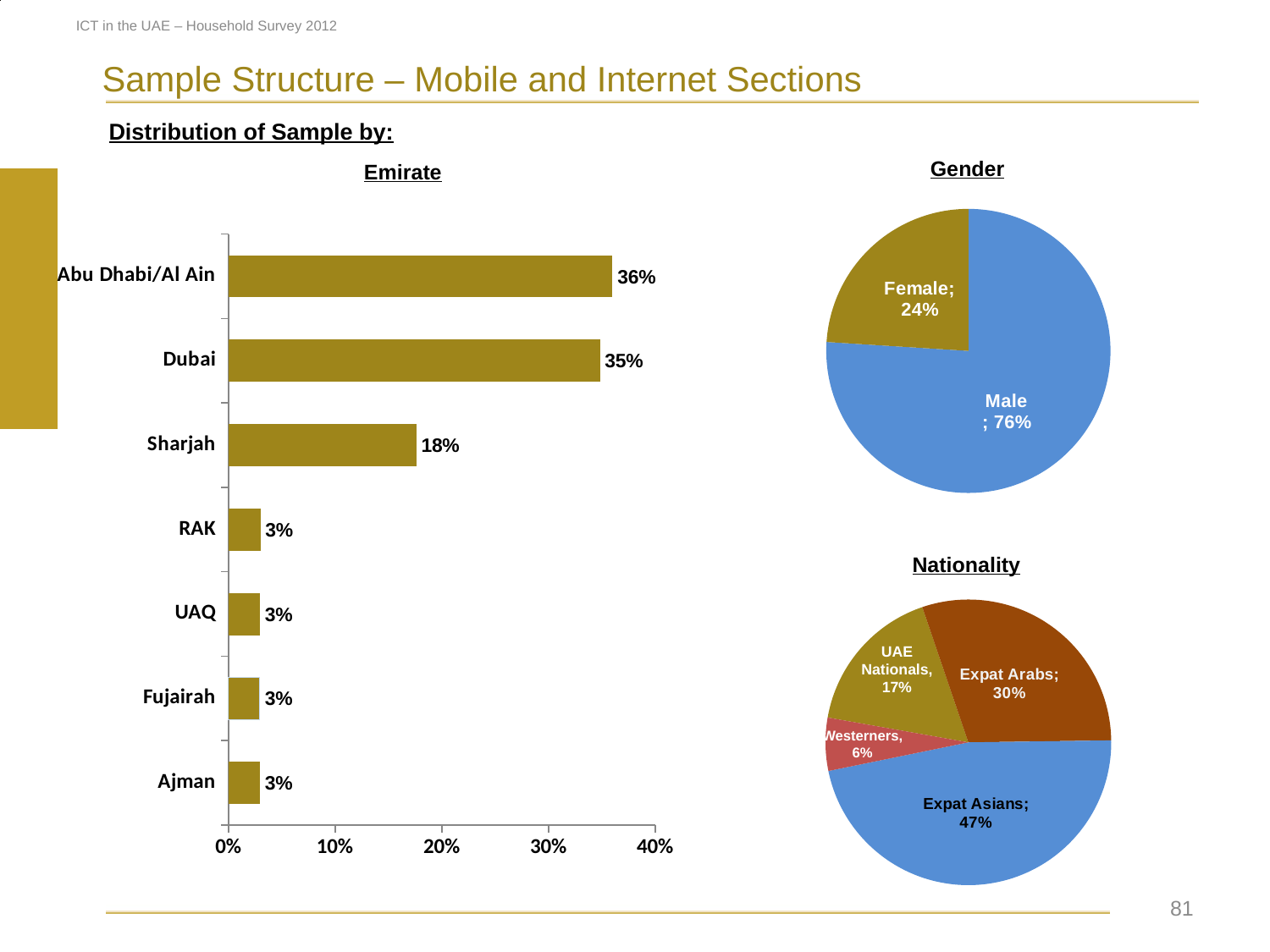
In the Emirate bar chart, which emirate has the highest value? Abu Dhabi/Al Ain In the Emirate bar chart, how many emirates are shown? 7 In the Nationality pie chart, how many slices are there? 4 In the Emirate bar chart, what is the difference between Abu Dhabi/Al Ain and Sharjah? 18% In the Emirate bar chart, what is the value for Dubai? 35% In the Gender pie chart, which slice is larger, Male or Female? Male In the Gender pie chart, what share is Female? 24% What kind of chart is the Emirate chart? Bar chart In the Nationality pie chart, what share is Expat Asians? 47% In the Nationality pie chart, which group has the smallest share? Westerners In the Emirate bar chart, what is the value for Sharjah? 18% In the Emirate bar chart, which is larger, Dubai or Sharjah? Dubai